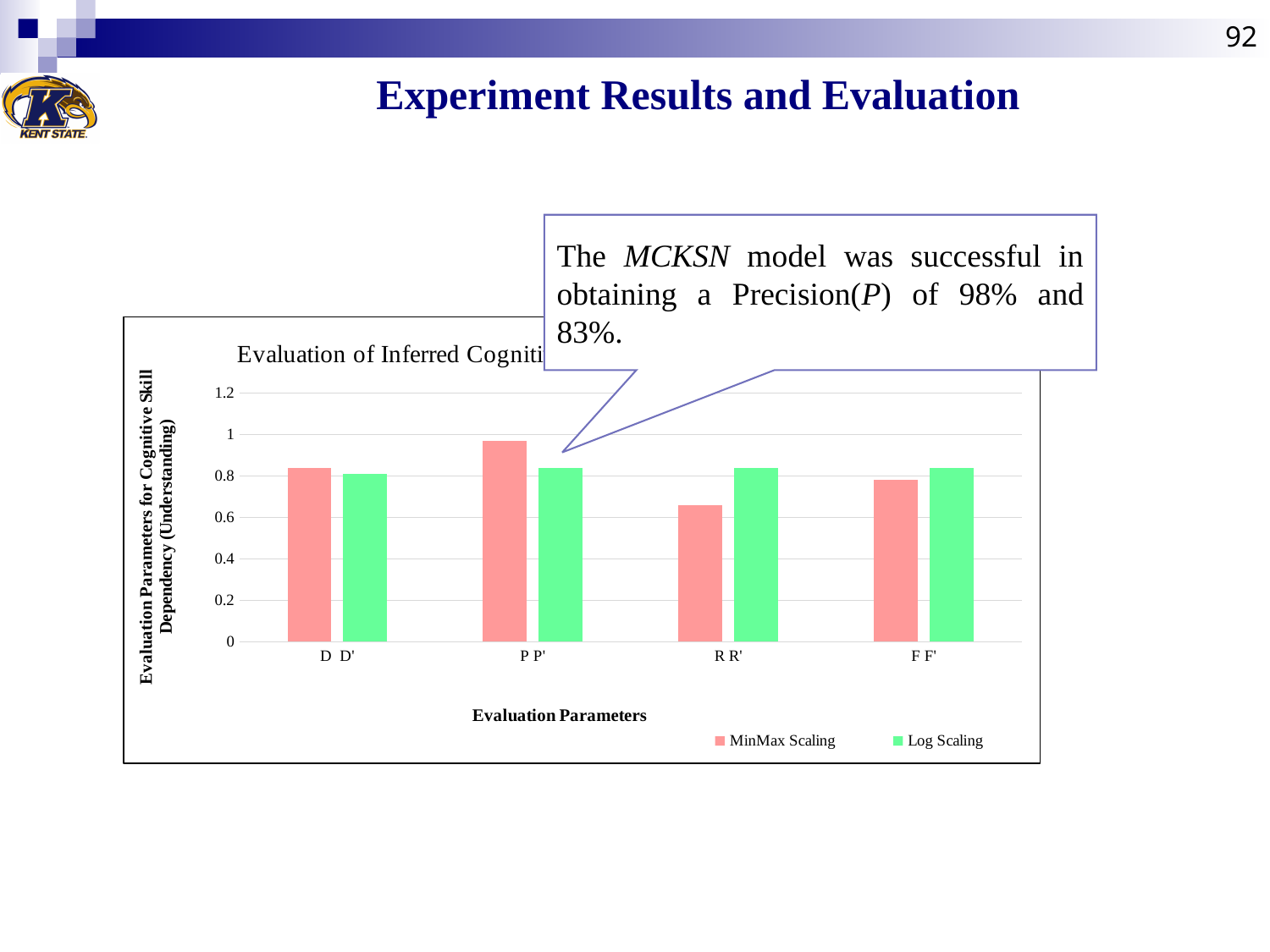
Is the MinMax Scaling value for R R' greater or less than 0.8? less How many categories are shown on the x axis of the chart? 4 For which category is the MinMax Scaling bar the lowest? R R' For the category P P', which series has the larger value, MinMax Scaling or Log Scaling? MinMax Scaling For the category R R', which series has the larger value, MinMax Scaling or Log Scaling? Log Scaling Is the MinMax Scaling value for R R' greater or less than 0.6? greater Is the MinMax Scaling value for P P' greater or less than 0.8? greater For which category is the MinMax Scaling bar the highest? P P' How many series does the chart's legend list? 2 Which series are listed in the chart's legend? MinMax Scaling and Log Scaling What is the title of the x axis of the chart? Evaluation Parameters What kind of chart is shown on the slide? bar chart